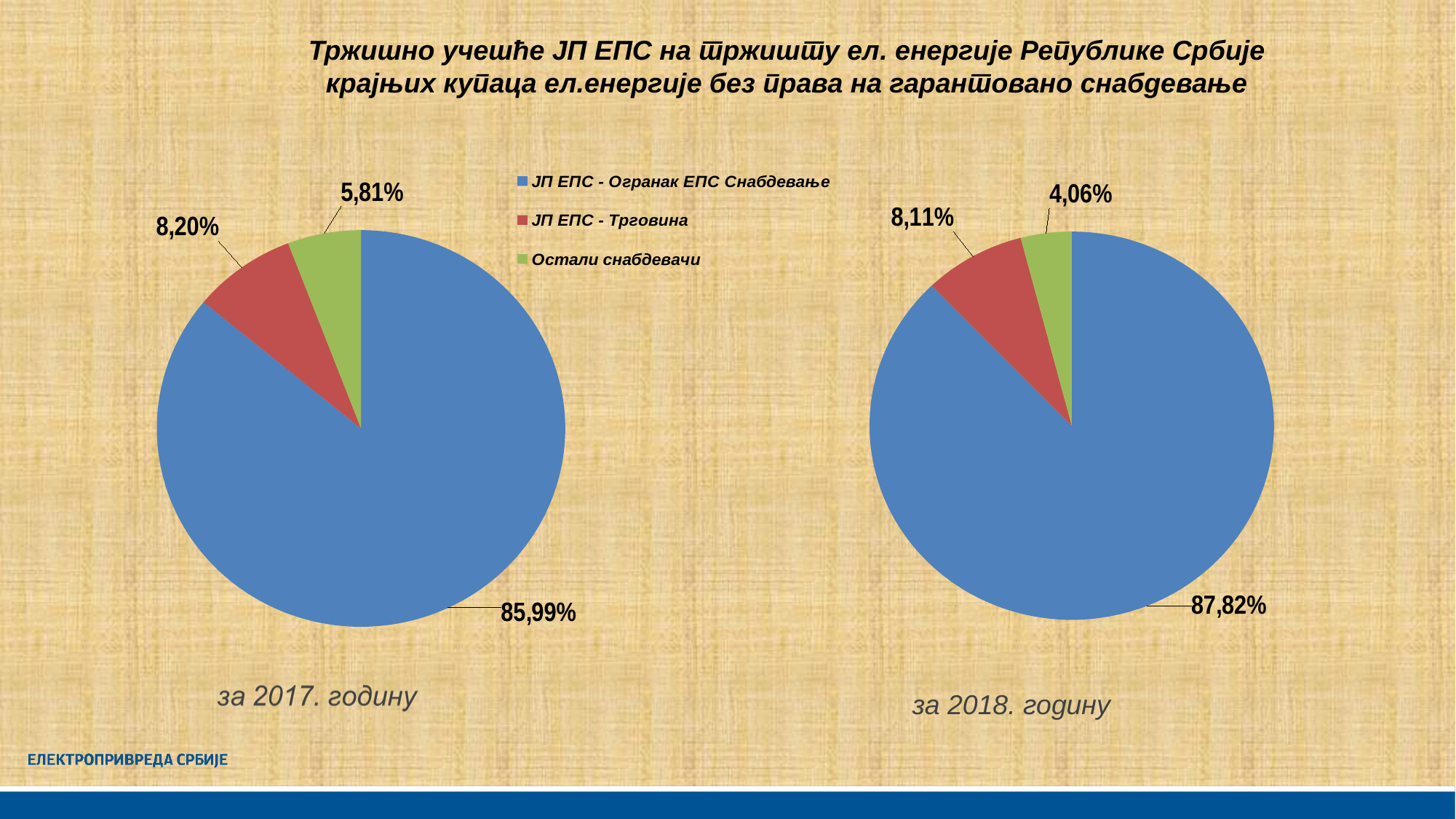
In the left pie chart (за 2017. годину), what share does ЈП ЕПС - Огранак ЕПС Снабдевање hold? 85,99% In the right pie chart (за 2018. годину), what share do Остали снабдевачи hold? 4,06% In the right pie chart (за 2018. годину), which category has the largest slice? ЈП ЕПС - Огранак ЕПС Снабдевање How many slices does each pie chart on the slide have? 3 In the left pie chart (за 2017. годину), what share do Остали снабдевачи hold? 5,81% What is the difference between the share of ЈП ЕПС - Огранак ЕПС Снабдевање in the right chart (2018) and in the left chart (2017)? 1,83% In the left pie chart (за 2017. годину), which category has the smallest slice? Остали снабдевачи What type of chart is used on this slide? Pie chart In the right pie chart (за 2018. годину), what share does ЈП ЕПС - Трговина hold? 8,11% In the left pie chart (за 2017. годину), which is larger: the slice for ЈП ЕПС - Трговина or the slice for Остали снабдевачи? ЈП ЕПС - Трговина In the right pie chart (за 2018. годину), what share does ЈП ЕПС - Огранак ЕПС Снабдевање hold? 87,82% In the left pie chart (за 2017. годину), what share does ЈП ЕПС - Трговина hold? 8,20%